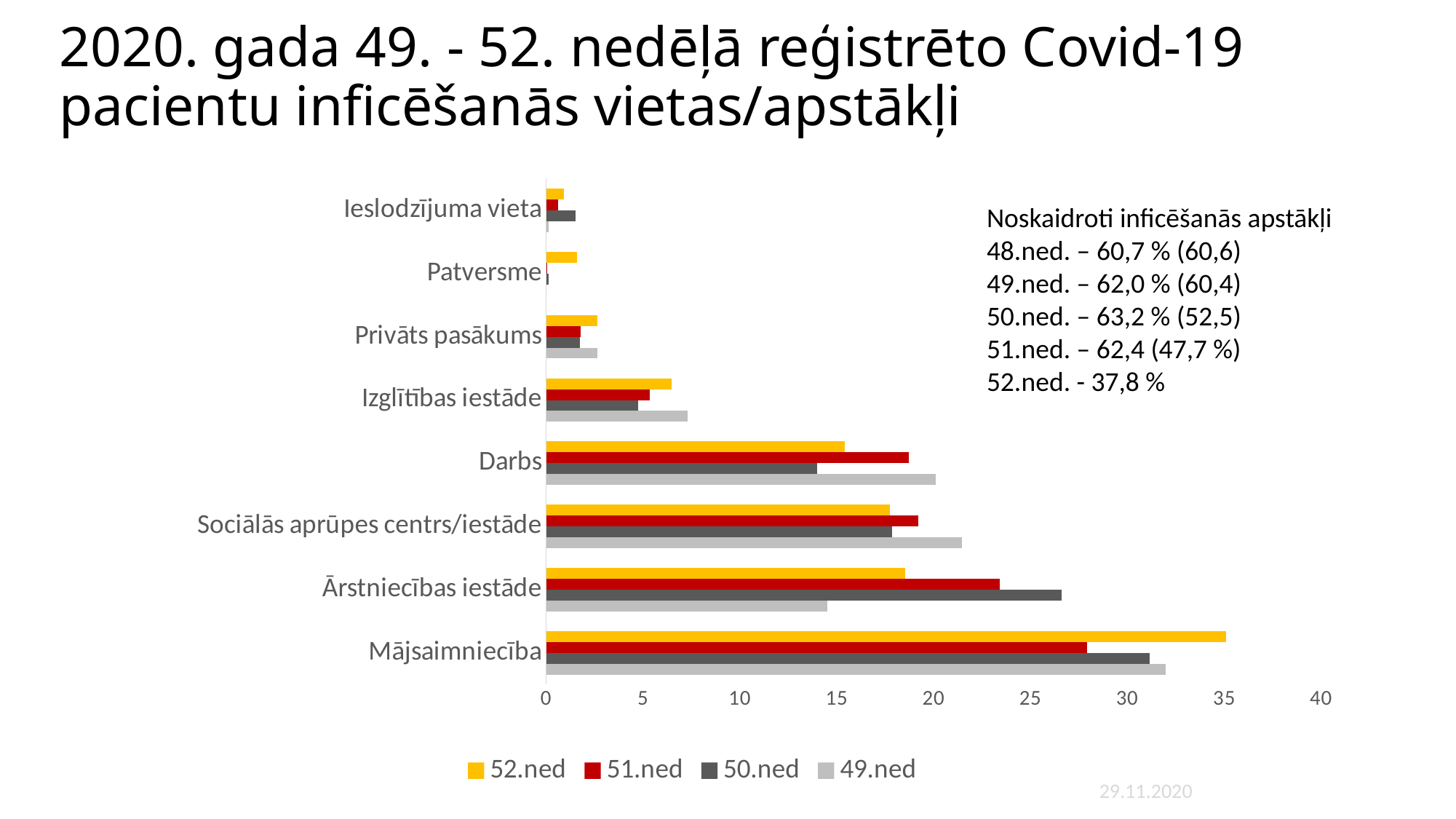
How many series does the chart legend list? 4 Which category has the highest value for the 52.ned series? Mājsaimniecība Which series has the highest value for Sociālās aprūpes centrs/iestāde? 49.ned Is the 52.ned value for Izglītības iestāde greater or less than 5? greater For Darbs, which series has the larger value: 49.ned or 52.ned? 49.ned What kind of chart is shown on the slide? bar chart Is the 51.ned value for Ārstniecības iestāde greater or less than 20? greater For Ārstniecības iestāde, which series has the larger value: 50.ned or 52.ned? 50.ned Is the 50.ned value for Mājsaimniecība greater or less than 30? greater How many categories are shown on the vertical axis of the chart? 8 What colour represents the 52.ned series in the chart legend? yellow